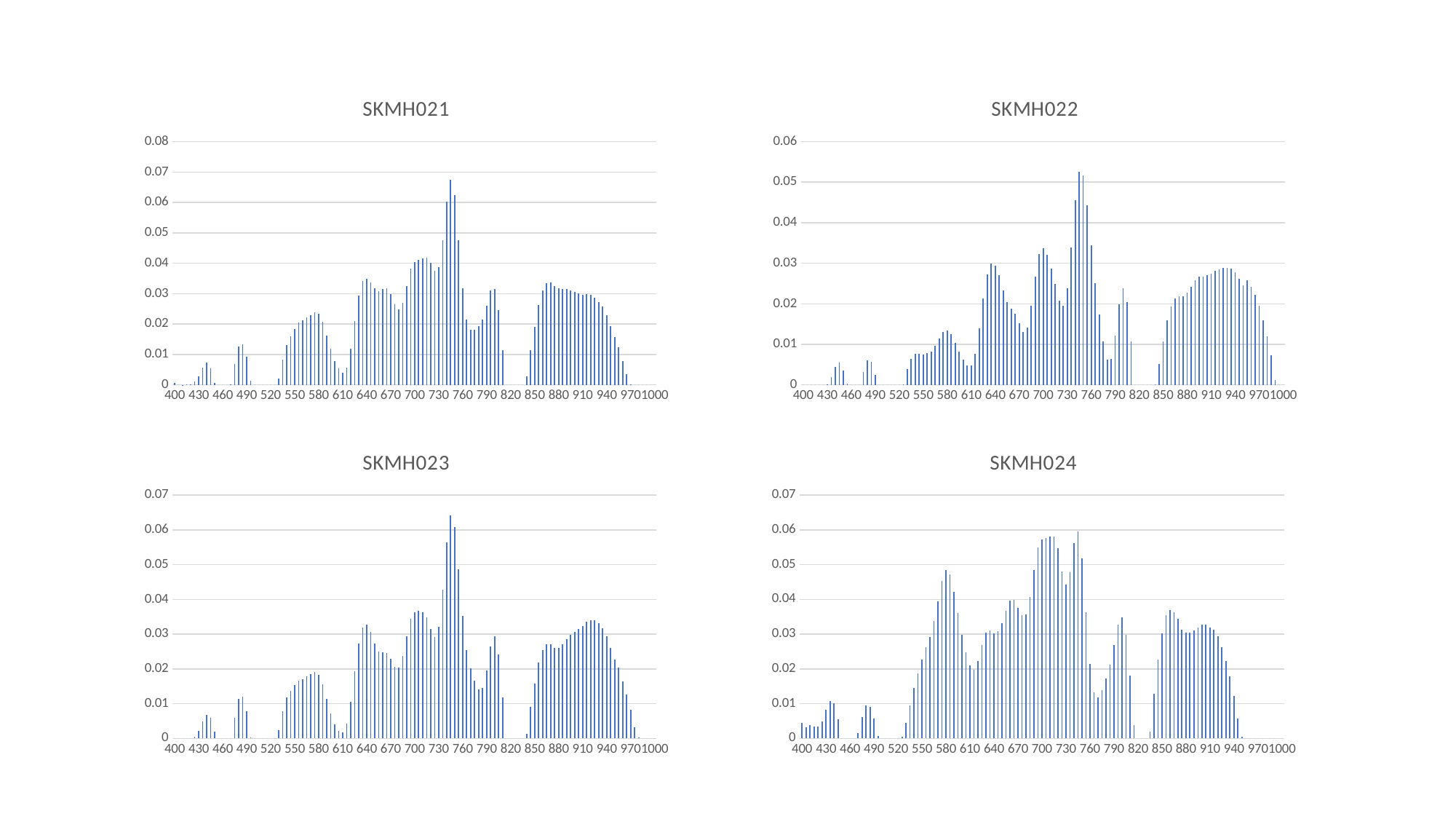
What kind of chart is SKMH021? bar chart In the SKMH021 chart, do the values rise or fall along the x axis between 880 and 970? fall In the SKMH021 chart, is the value at 850 greater or less than 0.04? less In the SKMH021 chart, what is the highest value labelled on the y axis? 0.08 How many charts are shown on the slide? 4 What is the lowest value labelled on the x axis of the SKMH024 chart? 400 In the SKMH022 chart, is the tallest bar greater or less than 0.04? greater In the SKMH023 chart, is the tallest bar greater or less than 0.05? greater In the SKMH023 chart, do the values rise or fall along the x axis between 520 and 580? rise What is the title of the top-left chart? SKMH021